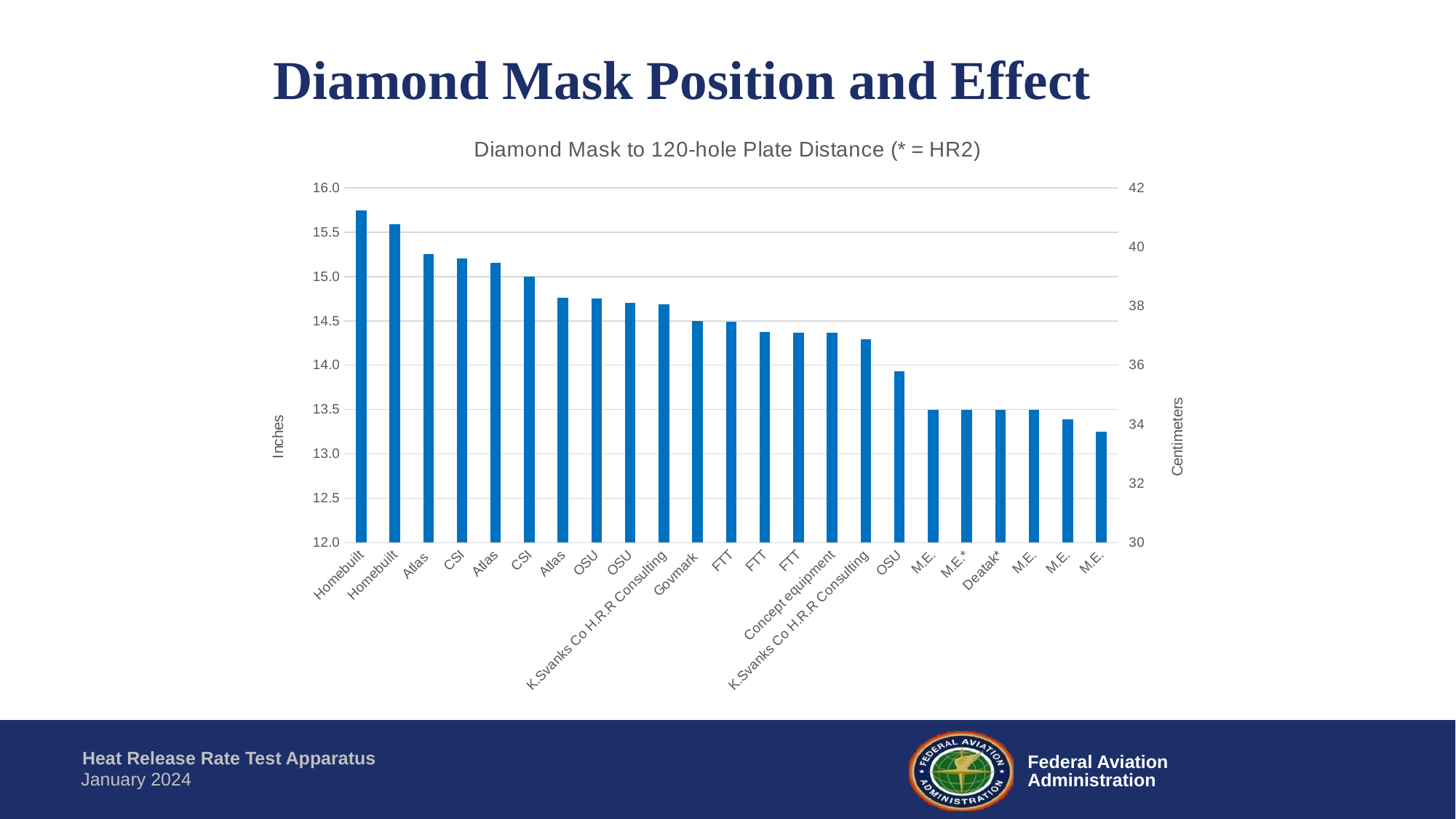
Which category has the shortest bar in the chart? M.E. Is the value for the first Homebuilt bar greater or less than 15.5 inches? greater Which category has the tallest bar in the chart? Homebuilt Which has the larger value, Govmark or Deatak*? Govmark Do the bar values rise or fall from left to right across the chart? fall What kind of chart is shown on the slide? bar chart Is the value for Govmark greater or less than 15.0 inches? less How many bars are plotted in the chart? 23 Is the value for Concept equipment greater or less than 14.5 inches? less What is the label of the left vertical axis? Inches What is the title of the chart? Diamond Mask to 120-hole Plate Distance (* = HR2)